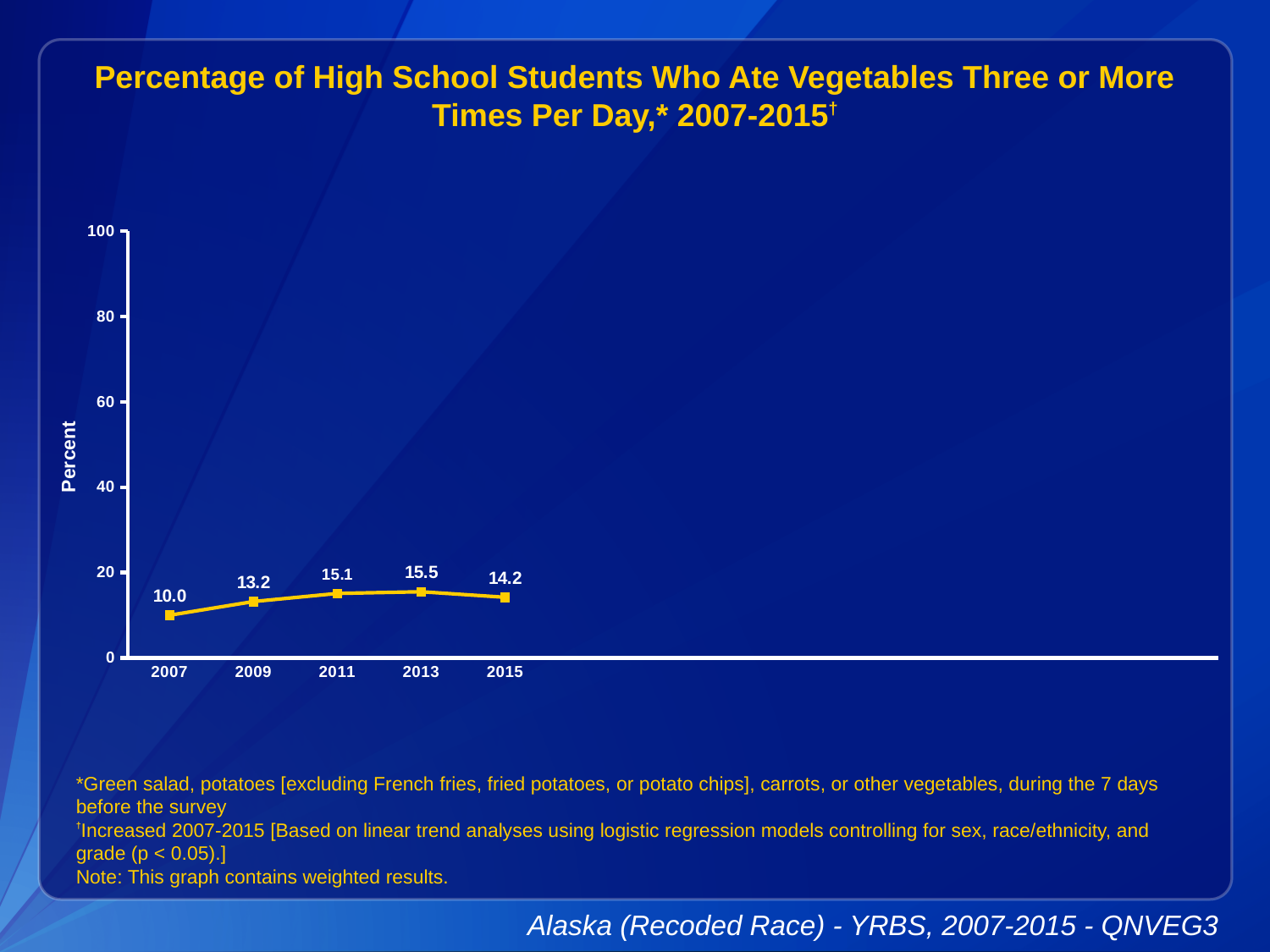
Which year has the highest value on the chart? 2013 Which year has the lowest value on the chart? 2007 Is the value for 2011 greater or less than 20? less Does the value rise or fall from 2013 to 2015? fall What is the value plotted for 2013? 15.5 What is the value plotted for 2015? 14.2 What kind of chart is shown on the slide? line chart What is the difference between the 2013 value and the 2007 value? 5.5 What is the label on the y axis? Percent How many years are plotted on the chart? 5 Which year has a larger value, 2009 or 2011? 2011 What percentage of high school students ate vegetables three or more times per day in 2007? 10.0